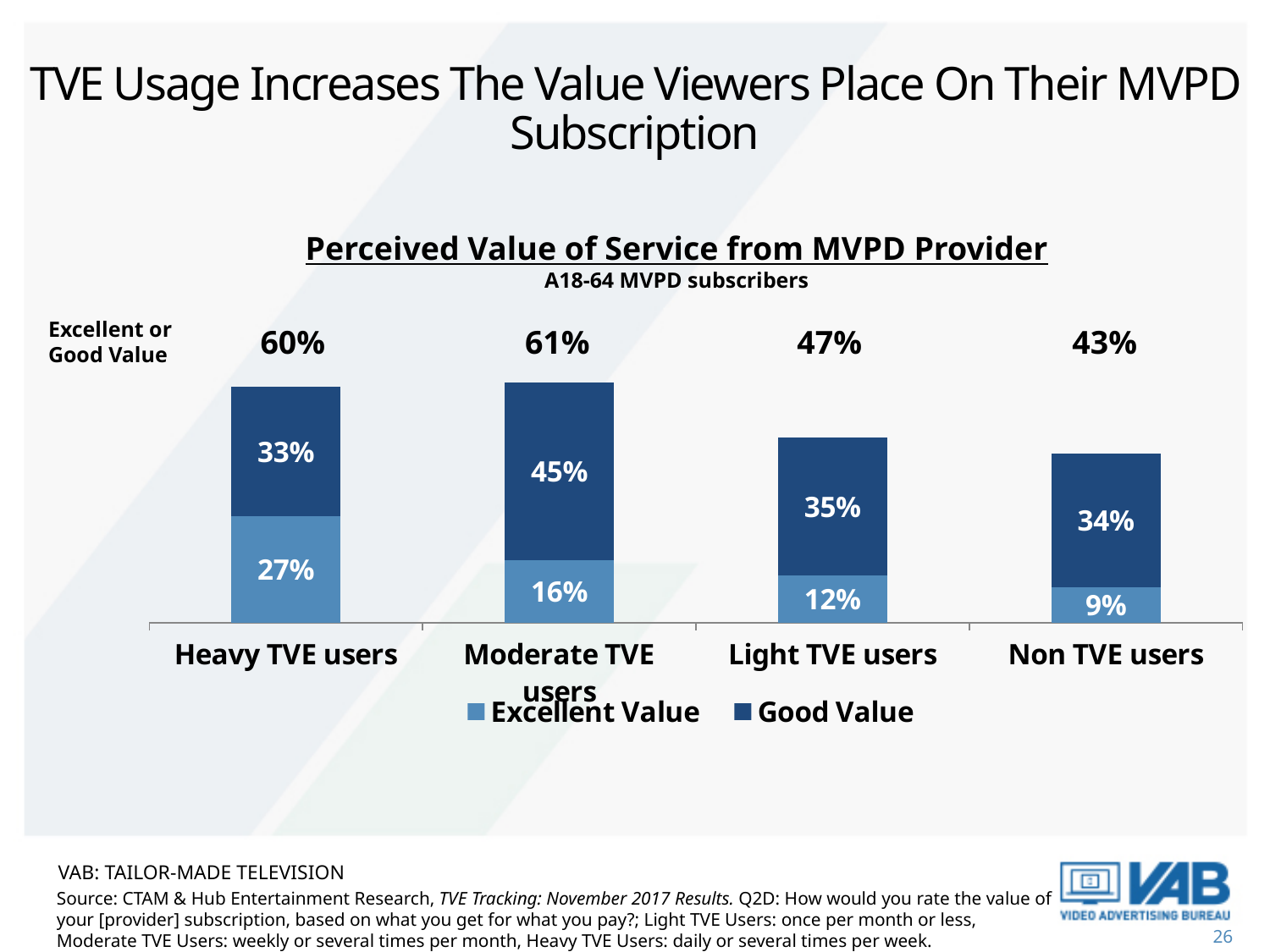
What is the Good Value percentage for Moderate TVE users? 45% What kind of chart is shown on the slide? Stacked bar chart What is the combined Excellent or Good Value total for Light TVE users? 47% What is the Excellent Value percentage for Non TVE users? 9% Which category has the highest combined Excellent or Good Value total? Moderate TVE users Which category has the lowest Excellent Value percentage? Non TVE users How many categories are shown on the x axis? 4 Which is larger: the Good Value percentage for Light TVE users or for Non TVE users? Light TVE users How many series does the legend list? 2 What is the difference between the Excellent Value percentages for Heavy TVE users and Non TVE users? 18% What is the title of the chart? Perceived Value of Service from MVPD Provider What is the Excellent Value percentage for Heavy TVE users? 27%